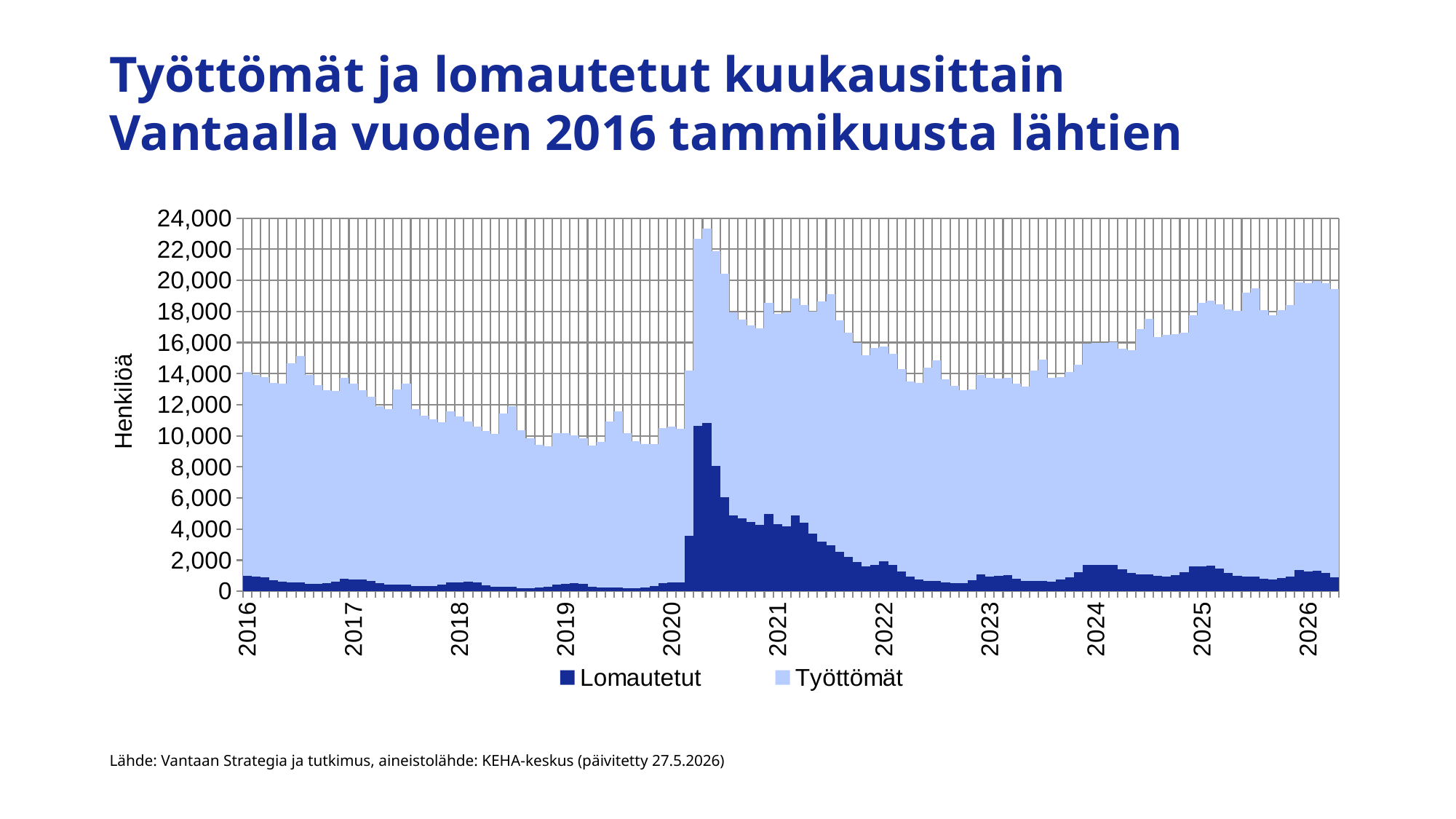
How many year labels are shown on the horizontal axis? 11 Is the value of Lomautetut during 2018 greater or less than 2,000? less What kind of chart is shown on the slide? Stacked bar chart How many series does the legend list? 2 What are the two series named in the legend? Lomautetut and Työttömät Is the stacked total at the start of 2016 greater or less than 12,000? greater In which year does the stacked total reach its highest peak? 2020 Does the stacked total rise or fall from 2016 to the end of 2019? fall What is the label on the vertical axis? Henkilöä Is the peak value of Lomautetut in 2020 greater or less than 8,000? greater Which series is larger in 2024, Lomautetut or Työttömät? Työttömät